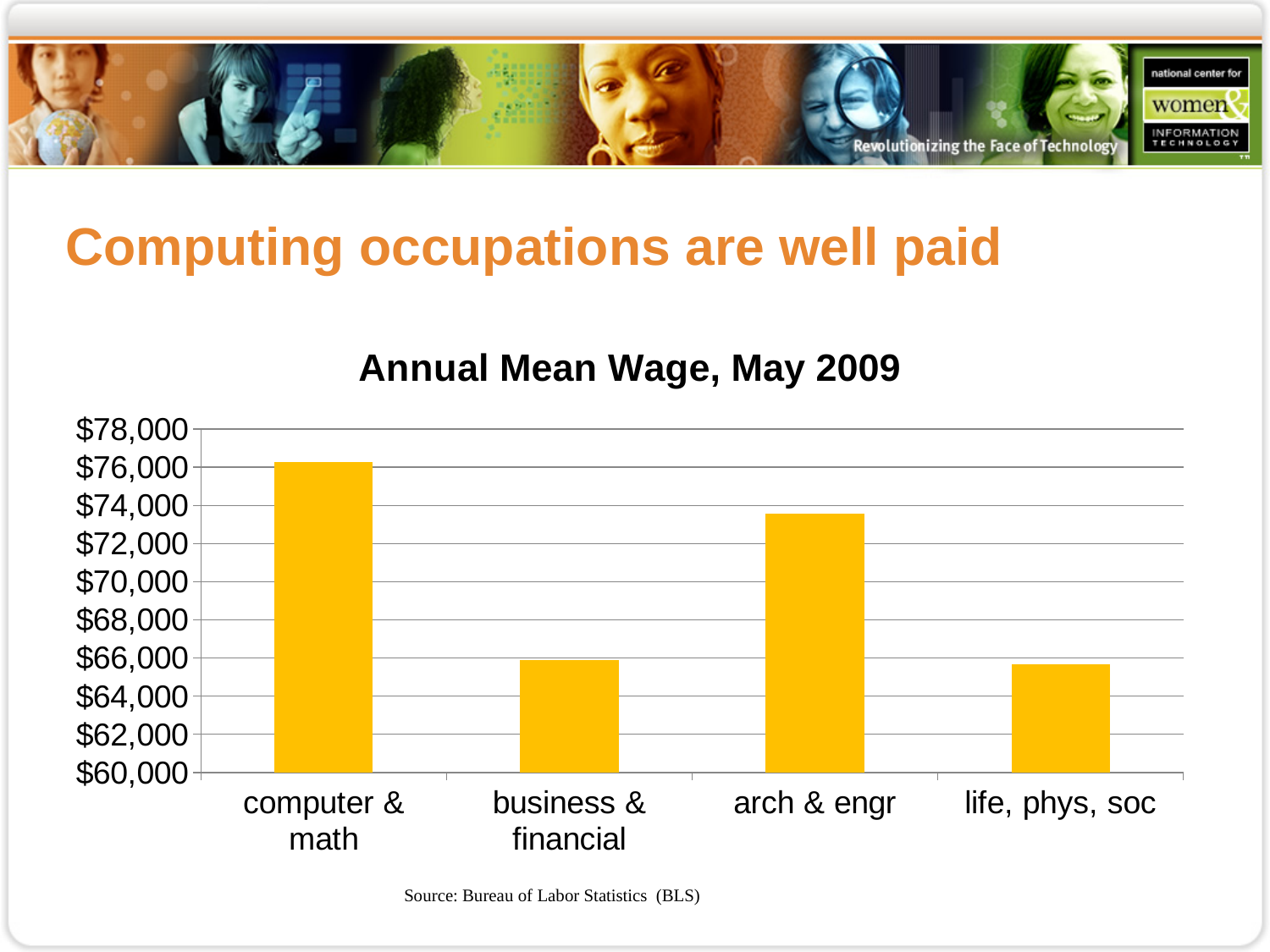
Is the annual mean wage for business & financial greater or less than $68,000? less Is the annual mean wage for life, phys, soc greater or less than $68,000? less Which has a higher annual mean wage, computer & math or arch & engr? computer & math What is the title of the chart? Annual Mean Wage, May 2009 Which category has the highest annual mean wage? computer & math What is the source cited for the chart data? Bureau of Labor Statistics (BLS) Which has a higher annual mean wage, arch & engr or business & financial? arch & engr What is the lowest value shown on the vertical axis? $60,000 Is the annual mean wage for arch & engr greater or less than $72,000? greater How many occupation categories are shown in the chart? 4 What kind of chart is shown on the slide? bar chart